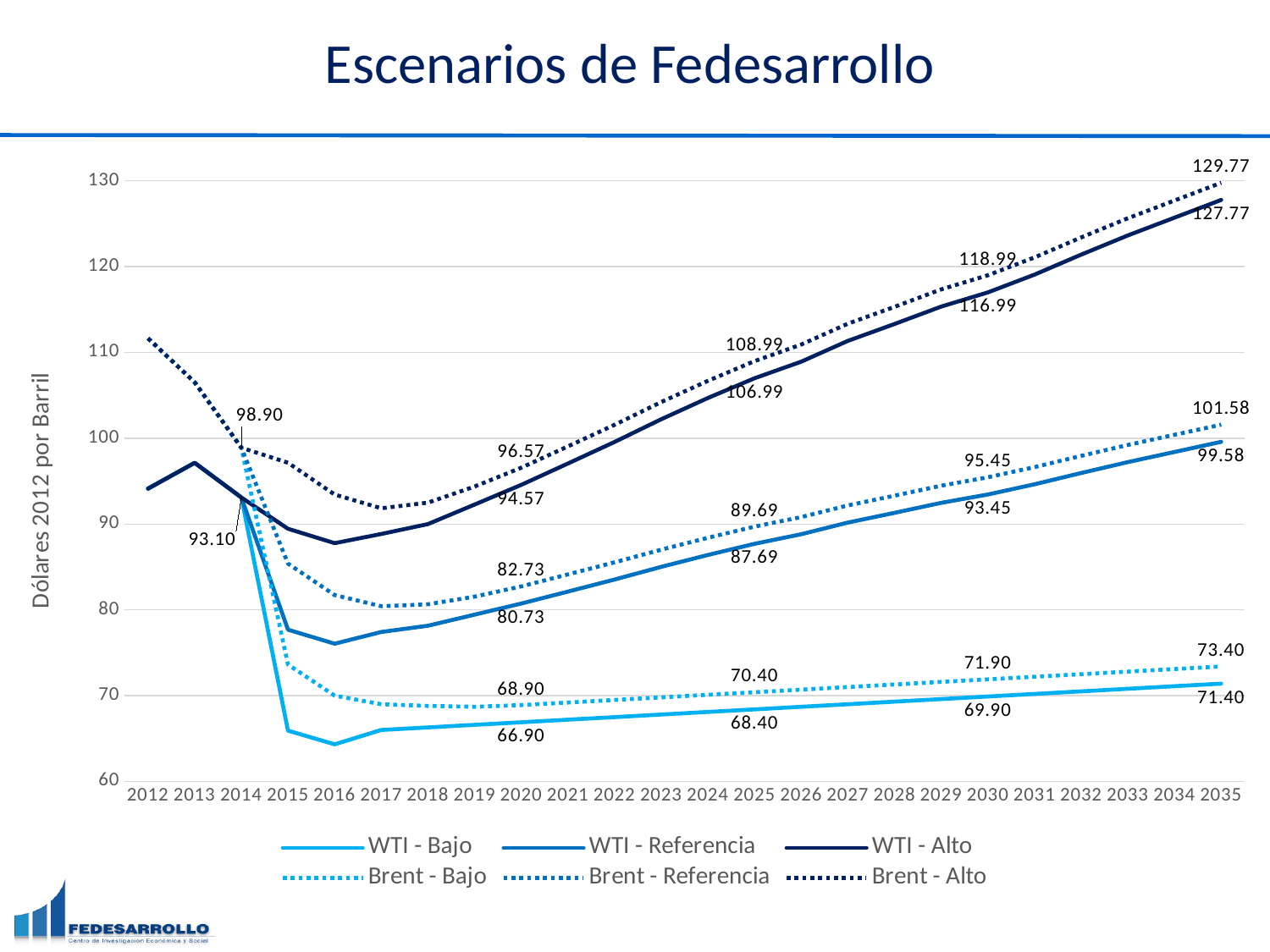
What is the value for WTI - Bajo in 2020? 66.90 Is the value for WTI - Bajo in 2016 greater or less than 70? less Which series has the lowest value in 2035? WTI - Bajo In 2030, which is larger: WTI - Referencia or Brent - Bajo? WTI - Referencia What is the difference between Brent - Alto and WTI - Alto in 2035? 2.00 How many years are shown on the x axis? 24 Which series has the highest value in 2035? Brent - Alto How many series does the legend list? 6 What is the value for WTI - Referencia in 2025? 87.69 Does the WTI - Alto series rise or fall from 2020 to 2035? rise What kind of chart is shown on the slide? line chart What is the value for Brent - Alto in 2035? 129.77